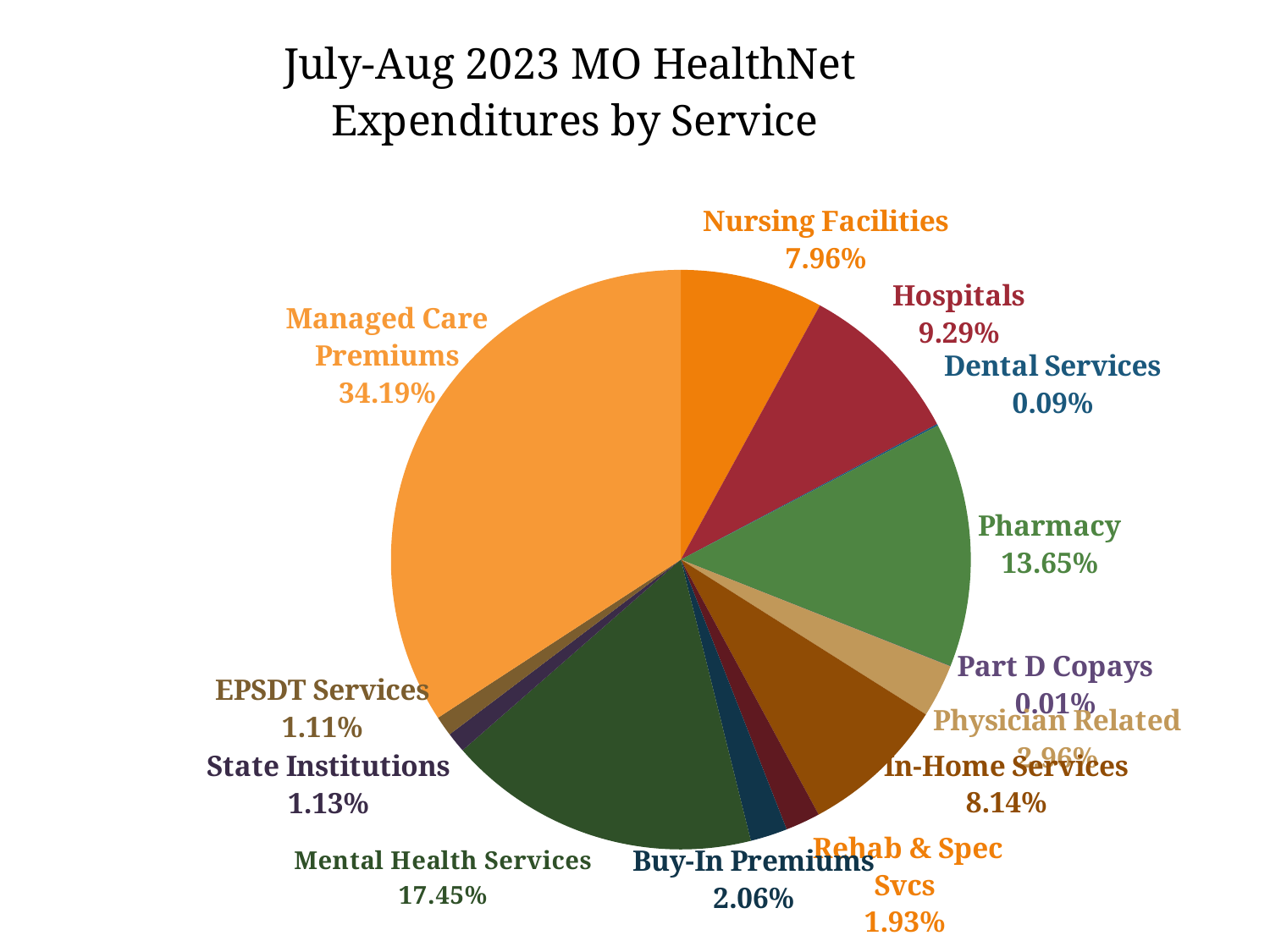
Which service category has the largest share of expenditures? Managed Care Premiums What is the difference in percentage points between Managed Care Premiums and Mental Health Services? 16.74% How many service categories are shown in the pie chart? 13 What percentage of expenditures is for Pharmacy? 13.65% What percentage of expenditures is for Managed Care Premiums? 34.19% What percentage of expenditures is for In-Home Services? 8.14% What is the difference in percentage points between Hospitals and Nursing Facilities? 1.33% Which has a larger share of expenditures, Mental Health Services or Pharmacy? Mental Health Services Which service category has the smallest share of expenditures? Part D Copays What kind of chart is shown on the slide? pie chart What is the title of the chart? July-Aug 2023 MO HealthNet Expenditures by Service What percentage of expenditures is for Mental Health Services? 17.45%